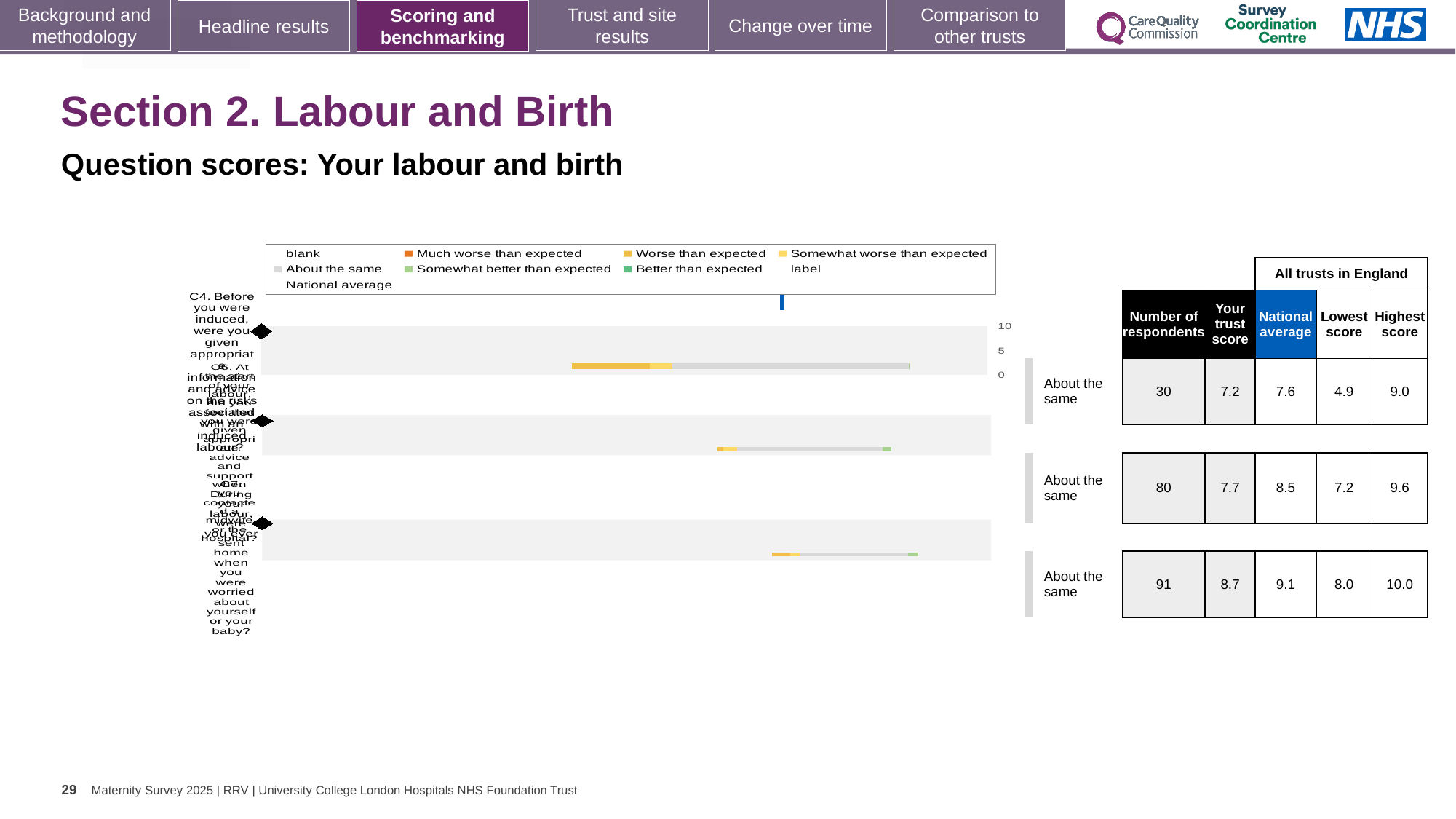
In the table beside the chart, what is the difference between the national average and the trust score for the first row? 0.4 Which row in the table beside the chart has the largest number of respondents? The third row (91) In the table beside the chart, what is the highest score for the third row? 10.0 In the table beside the chart, what is the lowest score for the first row? 4.9 In the table beside the chart, what is the number of respondents for the first row? 30 In the table beside the chart, for the second row, which is larger: the trust score or the national average? National average In the table beside the chart, what is the national average for the second row? 8.5 How many question rows are plotted in the chart? 3 What benchmark category label is shown for each of the three rows next to the chart? About the same What kind of chart is shown on the slide? Bar chart In the table beside the chart, what is the trust score for the third row? 8.7 How many entries does the chart legend list? 9